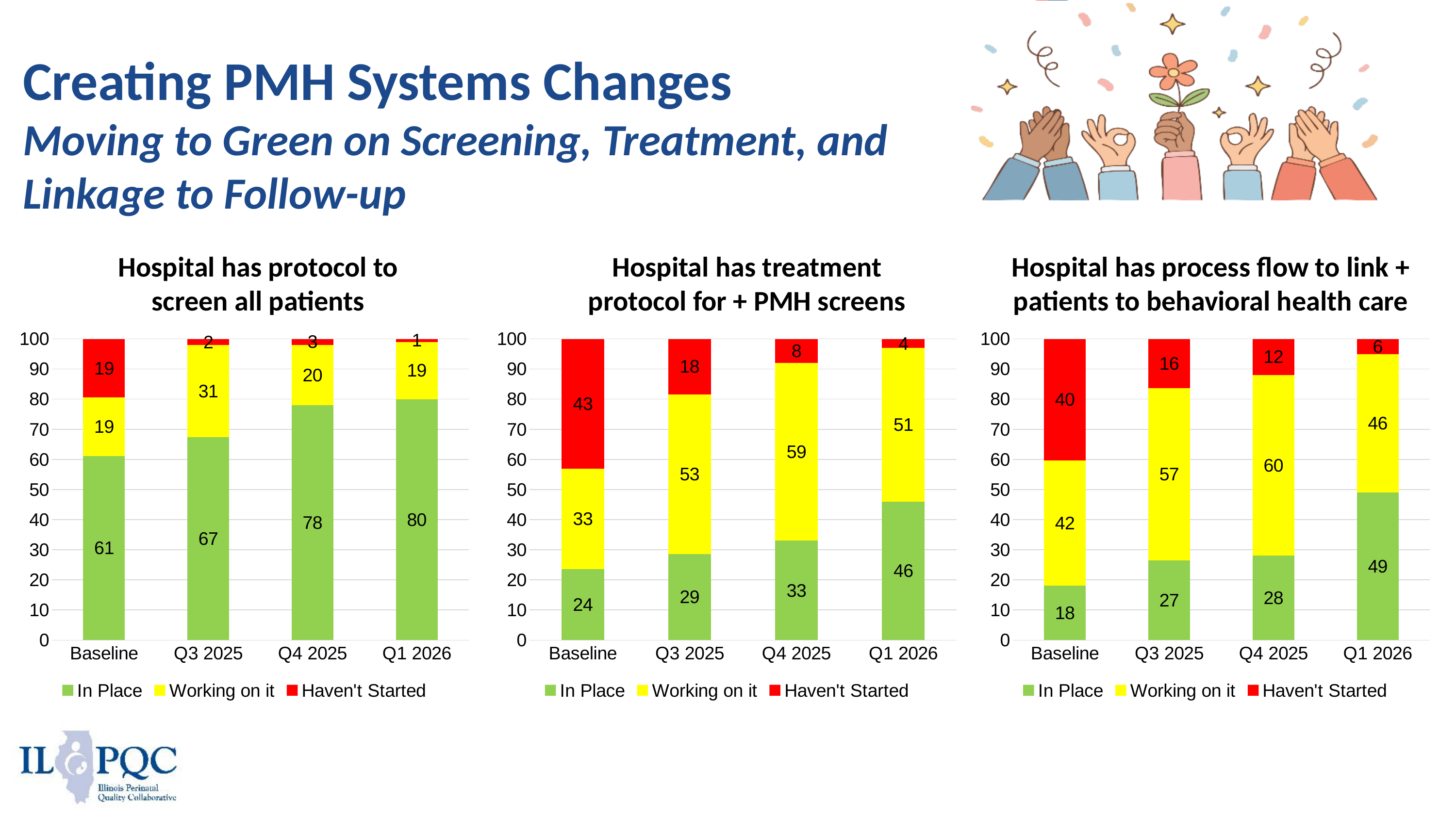
In the 'Hospital has process flow to link + patients to behavioral health care' chart, which period has the lowest 'In Place' value? Baseline How many series does the legend of the 'Hospital has process flow to link + patients to behavioral health care' chart list? 3 In the 'Hospital has protocol to screen all patients' chart, what is the difference between the 'In Place' values for Q1 2026 and Baseline? 19 What kind of chart is the 'Hospital has treatment protocol for + PMH screens' chart? Stacked bar chart In the 'Hospital has process flow to link + patients to behavioral health care' chart, what is the 'Haven't Started' value at Baseline? 40 In the 'Hospital has process flow to link + patients to behavioral health care' chart, does the 'Haven't Started' value rise or fall from Baseline to Q1 2026? Fall How many periods are shown on the x axis of the 'Hospital has protocol to screen all patients' chart? 4 In the 'Hospital has protocol to screen all patients' chart, what colour represents 'Working on it'? Yellow In the 'Hospital has treatment protocol for + PMH screens' chart, which is larger: the 'Haven't Started' value at Baseline or at Q3 2025? Baseline In the 'Hospital has treatment protocol for + PMH screens' chart, which period has the highest 'In Place' value? Q1 2026 In the 'Hospital has protocol to screen all patients' chart, what is the 'In Place' value for Q1 2026? 80 In the 'Hospital has treatment protocol for + PMH screens' chart, what is the 'Working on it' value for Q4 2025? 59